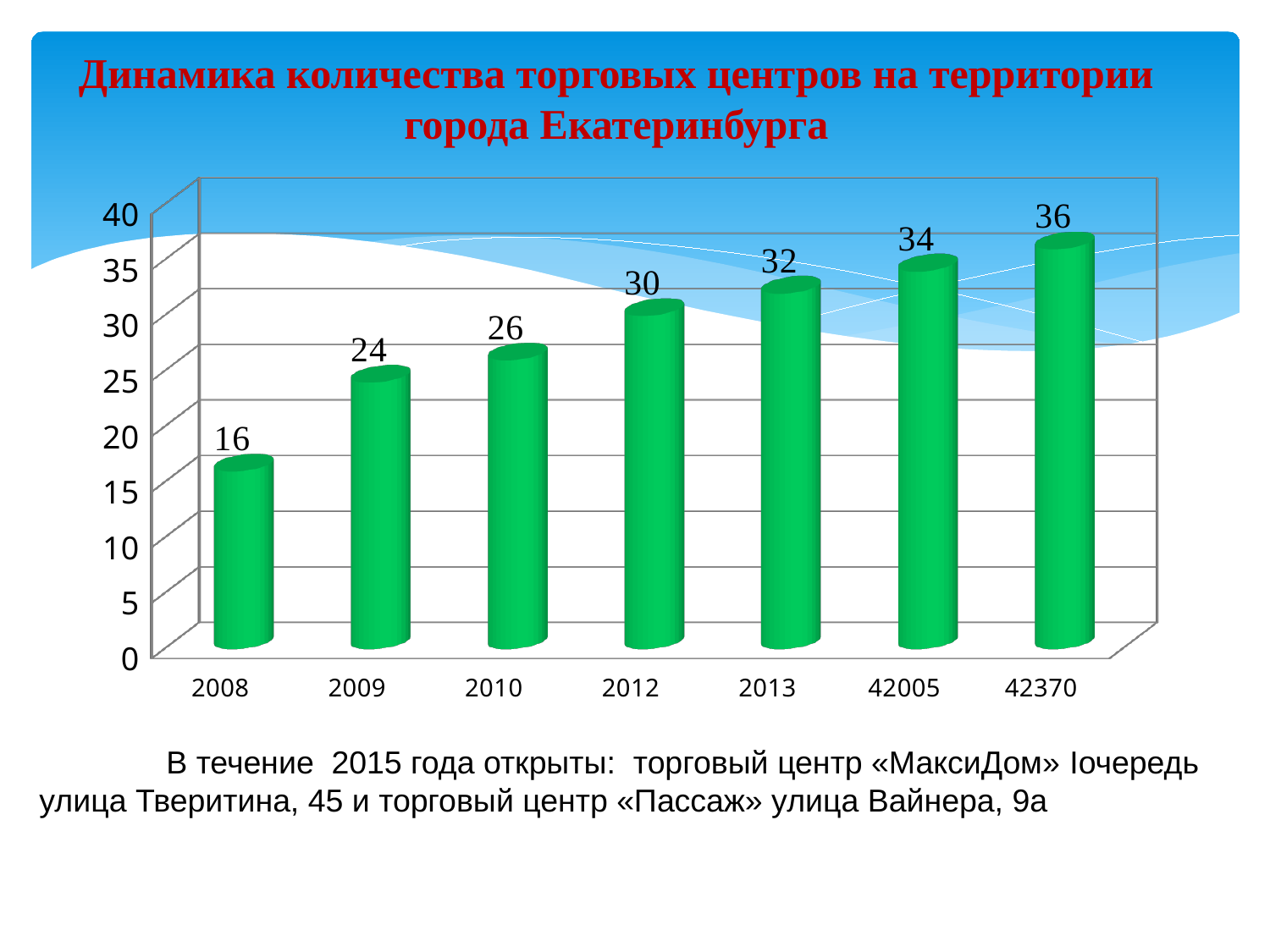
Which category has the highest value? 42370 What kind of chart is shown on the slide? bar chart What is the difference between the values for 42005 and 2013? 2 Which is larger, the value for 2010 or the value for 2013? 2013 Which category has the lowest value? 2008 What is the value for 2012? 30 What is the value for the category labelled 42370? 36 How many categories are shown on the x axis? 7 What is the value for 2008? 16 What is the difference between the values for 2009 and 2008? 8 Is the value for 2012 greater or less than 25? greater Do the values rise or fall from left to right along the x axis? rise